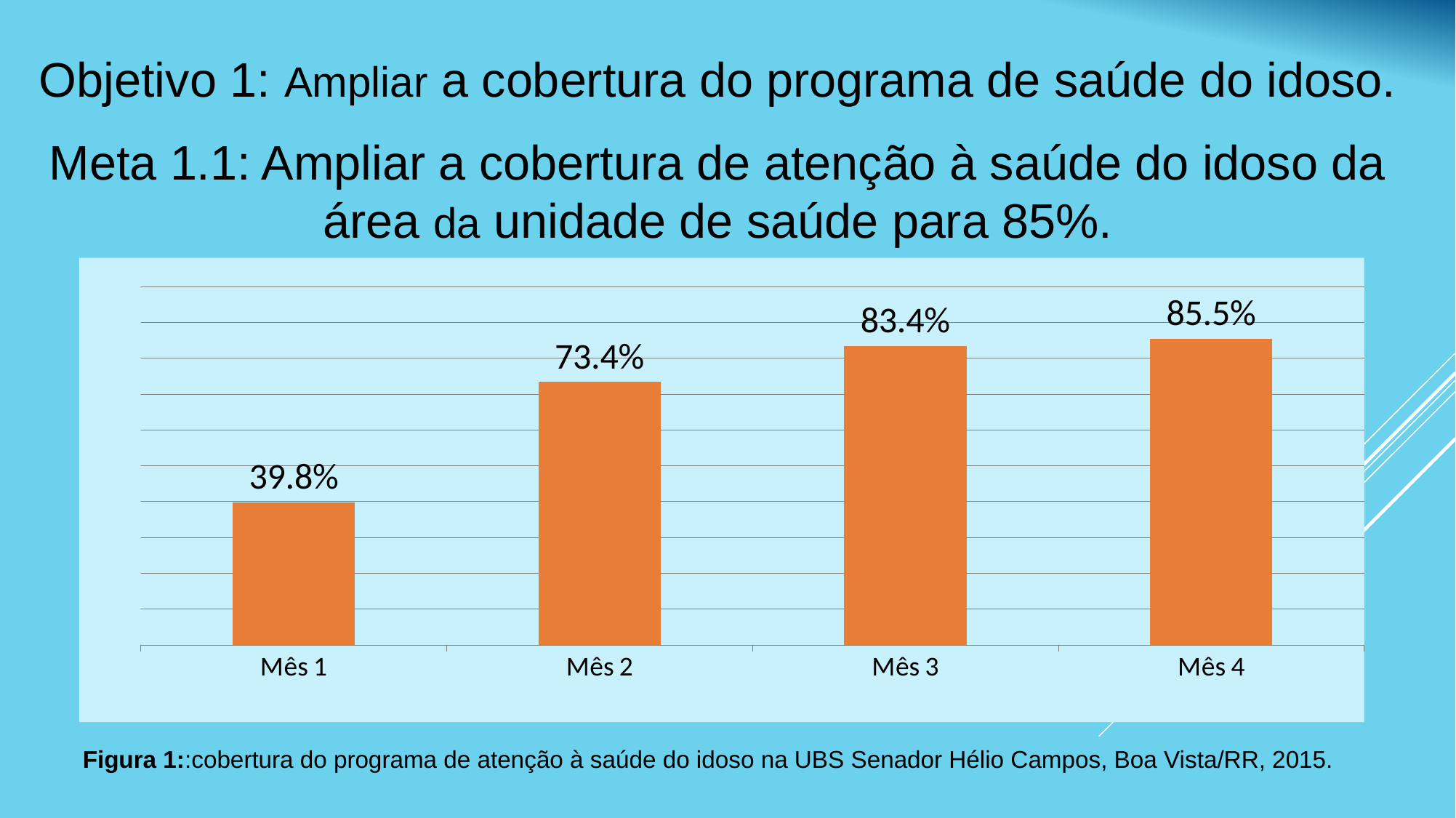
How many months are shown on the x axis? 4 What is the difference between the values for Mês 2 and Mês 1? 33.6% What is the value for Mês 4? 85.5% What is the value for Mês 1? 39.8% What is the value for Mês 3? 83.4% What kind of chart is shown on the slide? Bar chart Which month has the lowest value? Mês 1 Which is larger, the value for Mês 3 or the value for Mês 4? Mês 4 Do the values rise or fall from Mês 1 to Mês 4? Rise Which month has the highest value? Mês 4 What colour are the bars in the chart? Orange What is the value for Mês 2? 73.4%